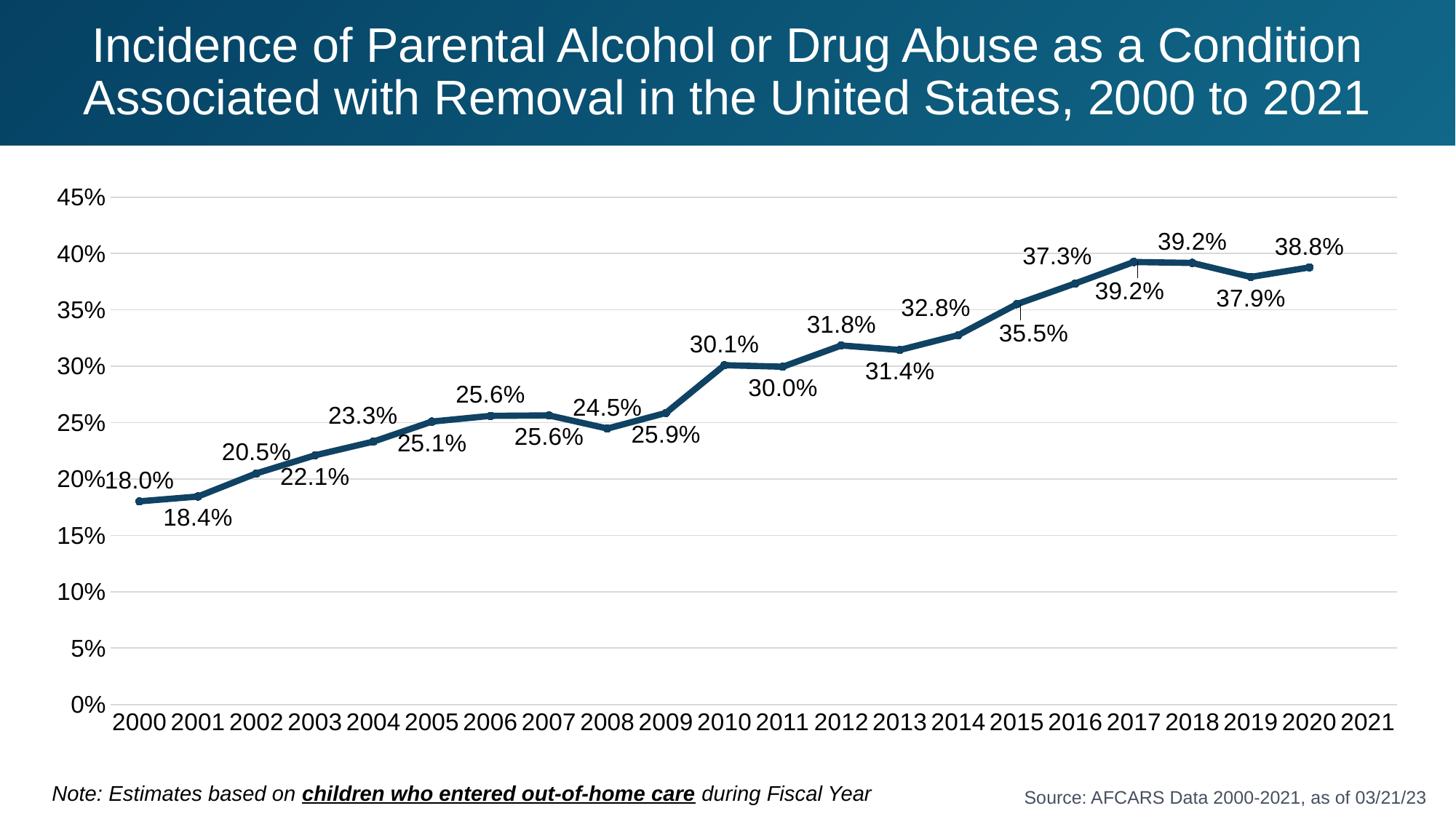
Which is larger, the value for 2012 or the value for 2013? 2012 Overall, do the values rise or fall from 2000 to the end of the series? rise What is the value for 2008? 24.5% What is the value for 2015? 35.5% Which year has the lowest value? 2000 Is the value for 2016 greater or less than 35%? greater What is the value for 2000? 18.0% What is the highest value plotted on the chart? 39.2% What type of chart is shown on the slide? line chart What is the title of the chart? Incidence of Parental Alcohol or Drug Abuse as a Condition Associated with Removal in the United States, 2000 to 2021 What is the difference between the values for 2010 and 2000? 12.1% What is the value for 2010? 30.1%